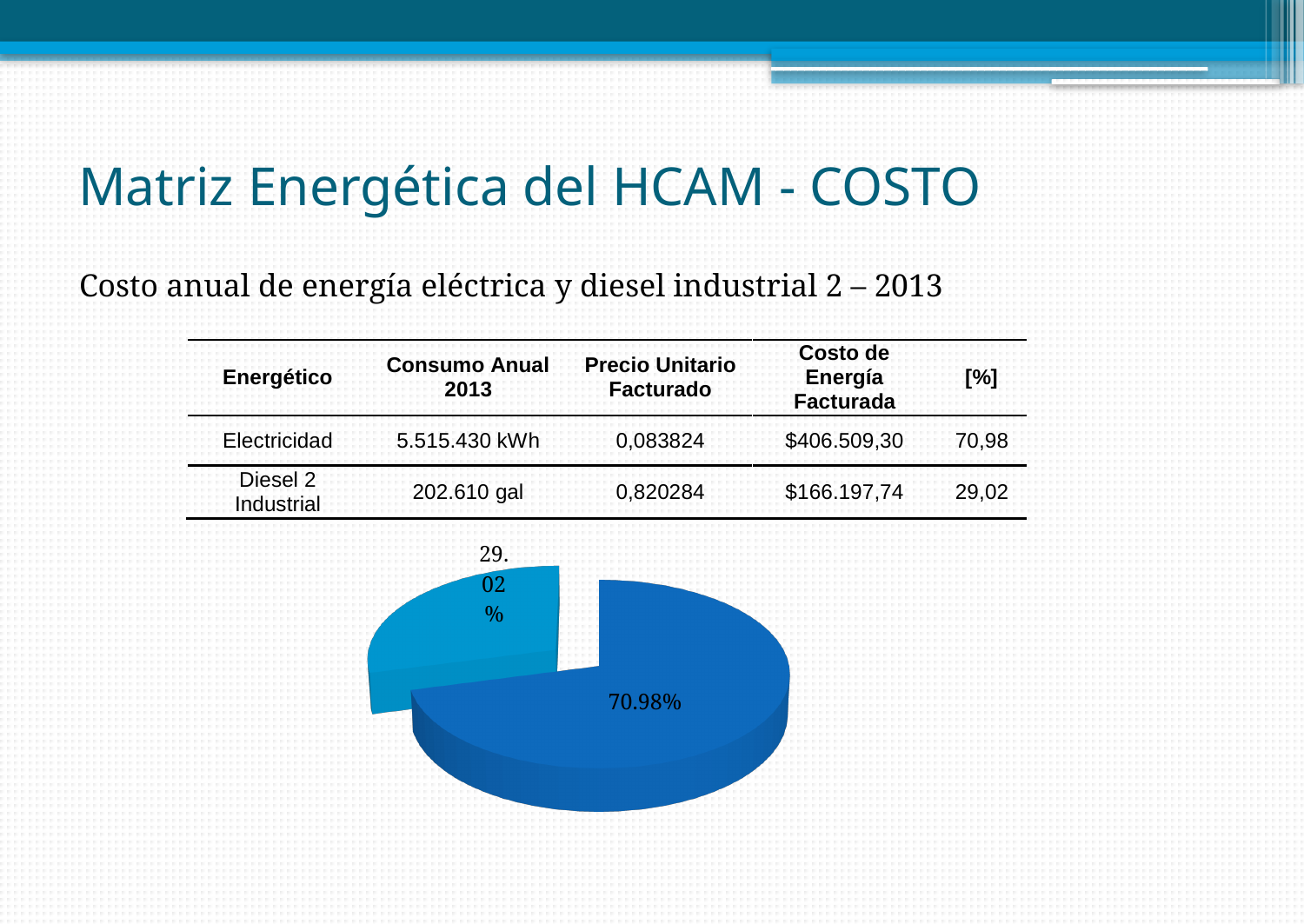
Is the pie chart drawn in 3D or flat 2D? 3D What is the share of the largest slice in the pie chart? 70.98% What is the difference in percentage points between the two slices of the pie chart? 41.96 What is the share of the smallest slice in the pie chart? 29.02% What percentage is shown on the dark blue slice of the pie chart? 70.98% Which slice of the pie chart is pulled out (exploded) from the rest? the light blue 29.02% slice According to the table on the slide, which energy source does the 70.98% slice of the pie chart correspond to? Electricidad What percentage is shown on the light blue slice of the pie chart? 29.02% How many slices does the pie chart have? 2 What kind of chart is shown on the slide? pie chart According to the table on the slide, which energy source does the 29.02% slice of the pie chart correspond to? Diesel 2 Industrial Which slice is larger in the pie chart, the dark blue one or the light blue one? the dark blue one